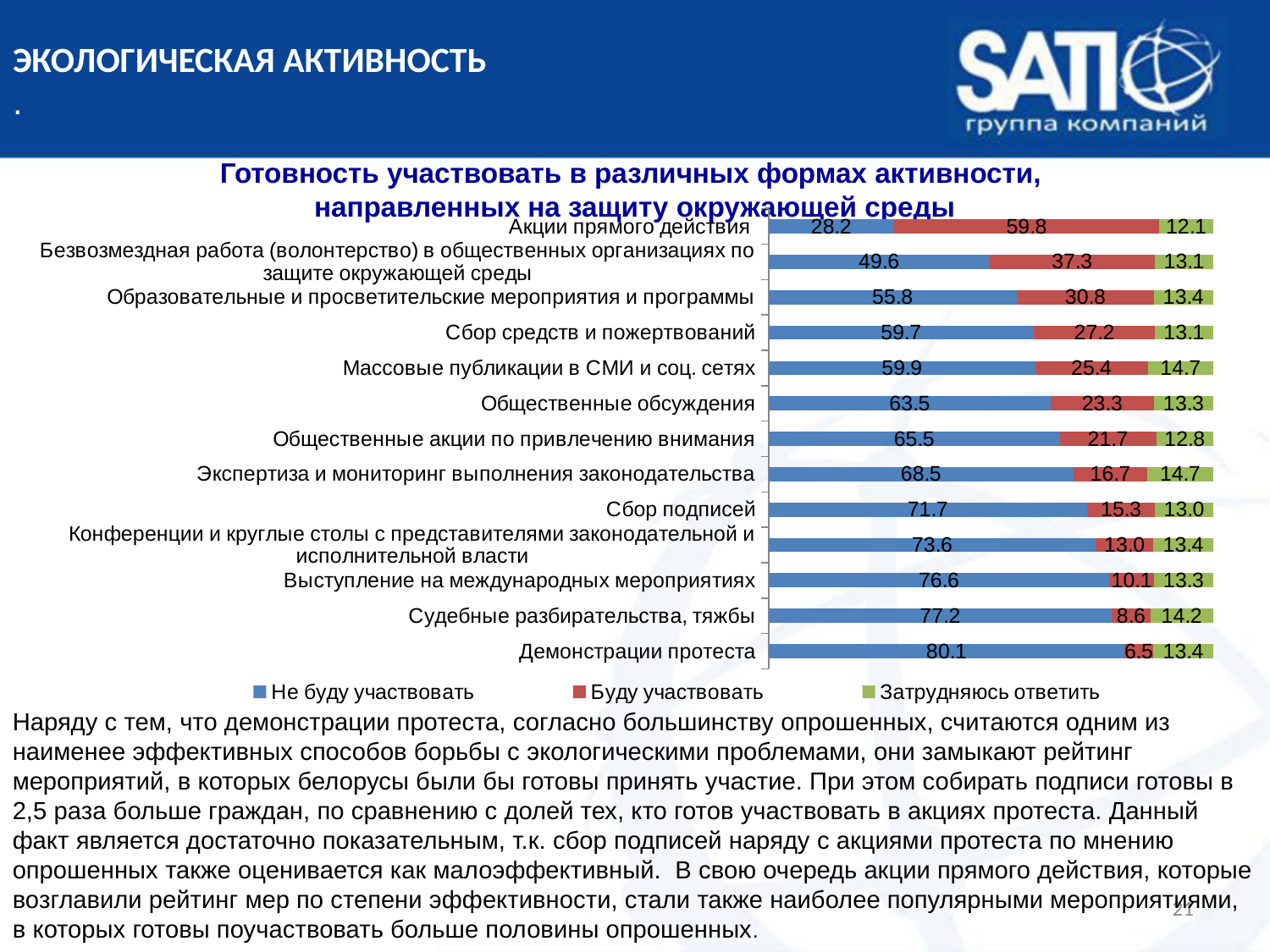
How many categories (forms of activity) are shown in the chart? 13 What is the value of 'Не буду участвовать' for 'Демонстрации протеста'? 80.1 What is the total of the stacked bar for 'Сбор подписей'? 100.0 What type of chart is shown on the slide? Stacked bar chart Which series is shown in blue in the legend? Не буду участвовать How many series does the legend list? 3 Which is larger: the 'Не буду участвовать' value for 'Сбор средств и пожертвований' or for 'Общественные обсуждения'? Общественные обсуждения What is the value of 'Затрудняюсь ответить' for 'Судебные разбирательства, тяжбы'? 14.2 Which category has the highest value for 'Буду участвовать'? Акции прямого действия What is the value of 'Буду участвовать' for 'Акции прямого действия'? 59.8 What is the difference between the 'Буду участвовать' values for 'Сбор подписей' and 'Демонстрации протеста'? 8.8 Which category has the lowest value for 'Не буду участвовать'? Акции прямого действия